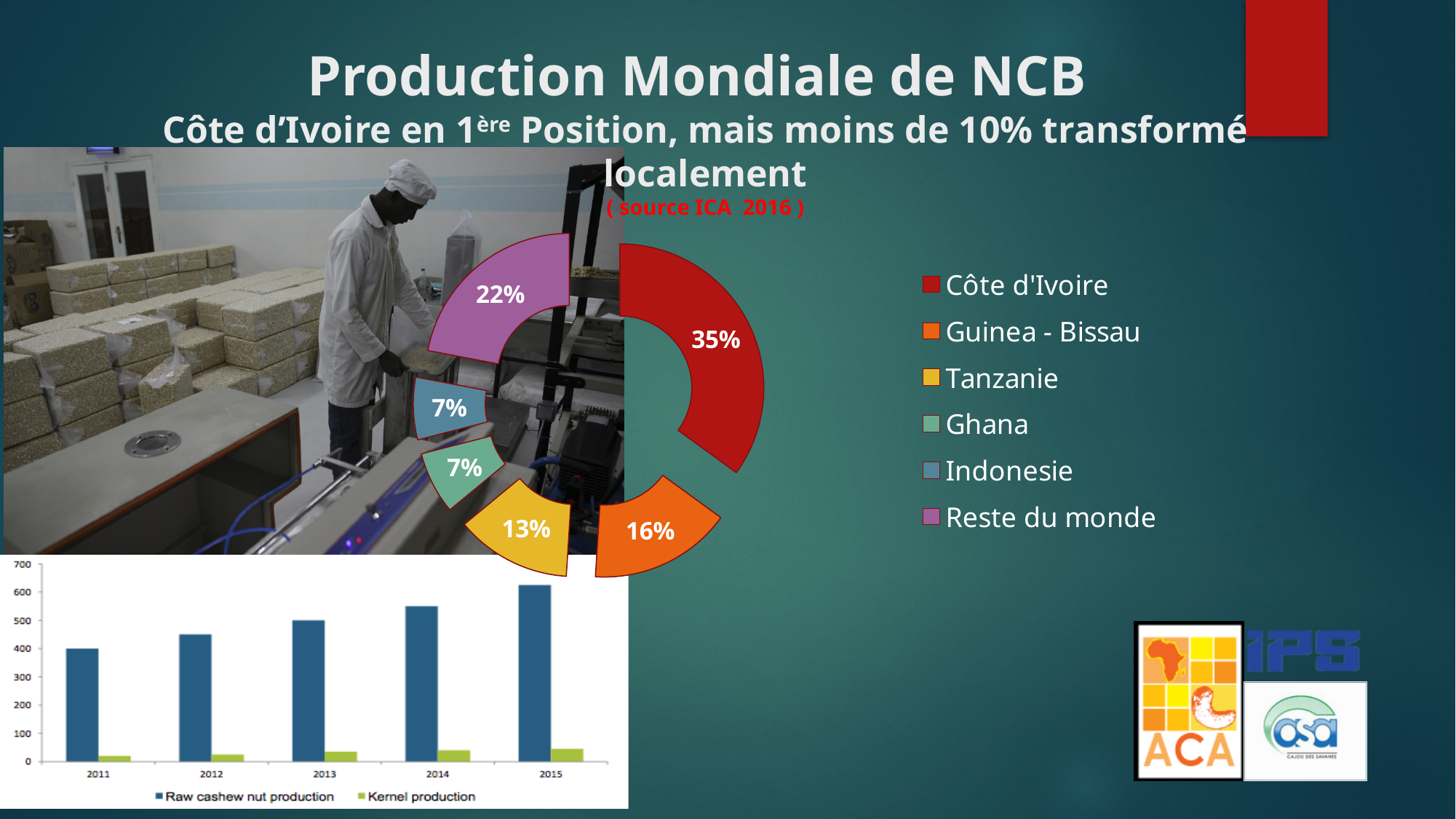
In the bottom-left bar chart, how many years are shown on the x axis? 5 In the doughnut chart, what is the difference between the shares of Côte d'Ivoire and Tanzanie? 22% In the doughnut chart, which category has the largest share? Côte d'Ivoire In the bottom-left bar chart, is the raw cashew nut production for 2015 greater or less than 600? greater How many entries does the legend of the doughnut chart list? 6 What kind of chart is the chart at the bottom left of the slide? bar chart In the doughnut chart, what share does Côte d'Ivoire hold? 35% In the doughnut chart, what share does Ghana hold? 7% In the doughnut chart, what share does Reste du monde hold? 22% In the doughnut chart, what share does Guinea - Bissau hold? 16% In the doughnut chart, which is larger, the share of Guinea - Bissau or the share of Tanzanie? Guinea - Bissau In the bottom-left bar chart, does raw cashew nut production rise or fall from 2011 to 2015? rise